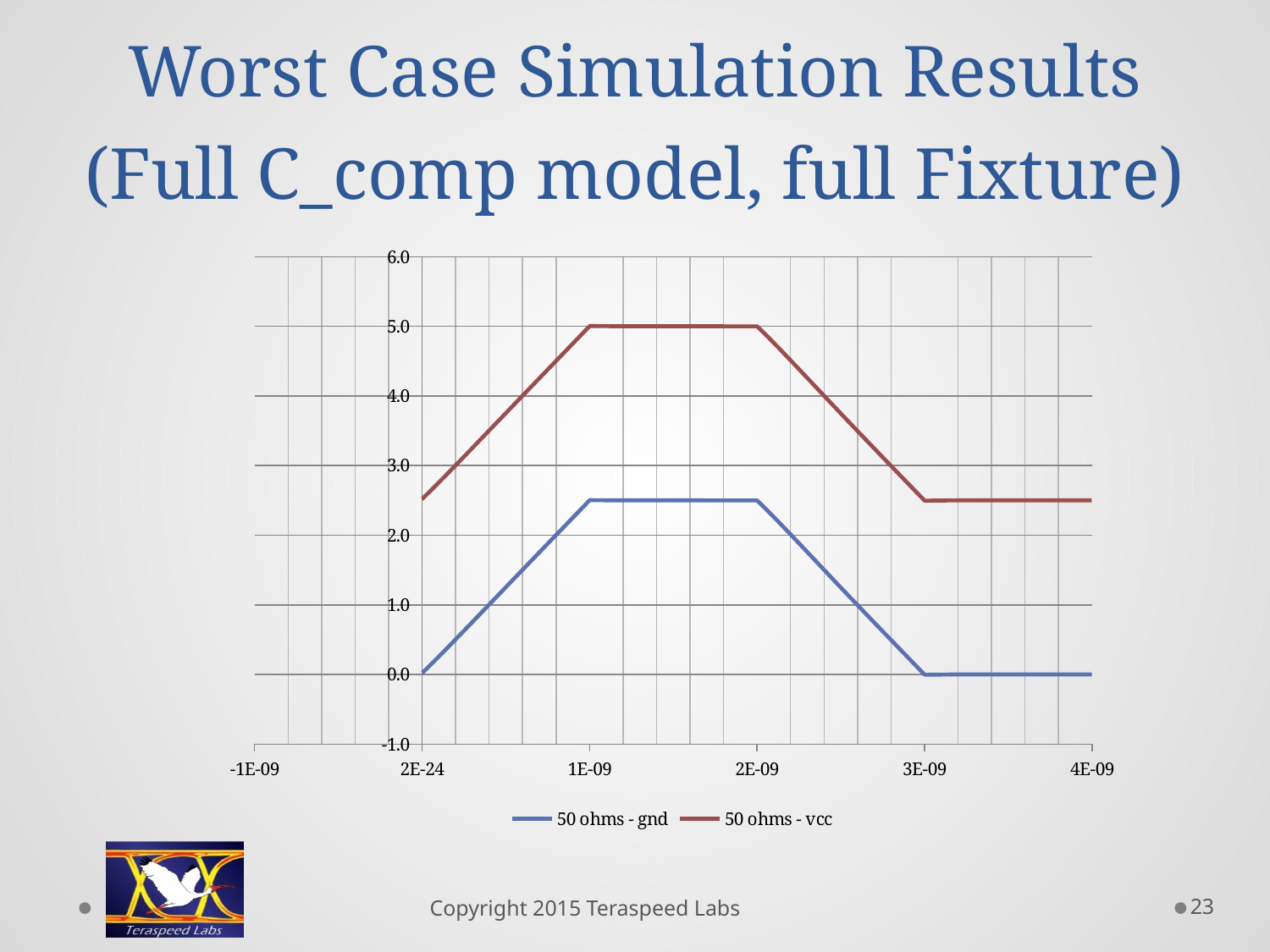
What is the value of the 50 ohms - vcc series at 1E-09? 5.0 Is the value of the 50 ohms - gnd series at 1E-09 greater or less than 3.0? less How many series does the legend list? 2 Which series has the higher value at 1E-09, 50 ohms - gnd or 50 ohms - vcc? 50 ohms - vcc Is the value of the 50 ohms - vcc series at 2E-24 greater or less than 2.0? greater Does the 50 ohms - gnd series rise or fall between 2E-09 and 3E-09? fall What is the value of the 50 ohms - gnd series at 3E-09? 0.0 What is the value of the 50 ohms - gnd series at 2E-24? 0.0 What colour is the line for the 50 ohms - gnd series? blue What is the value of the 50 ohms - vcc series at 2E-09? 5.0 What kind of chart is shown on the slide? line chart What is the highest value reached by the 50 ohms - vcc series? 5.0